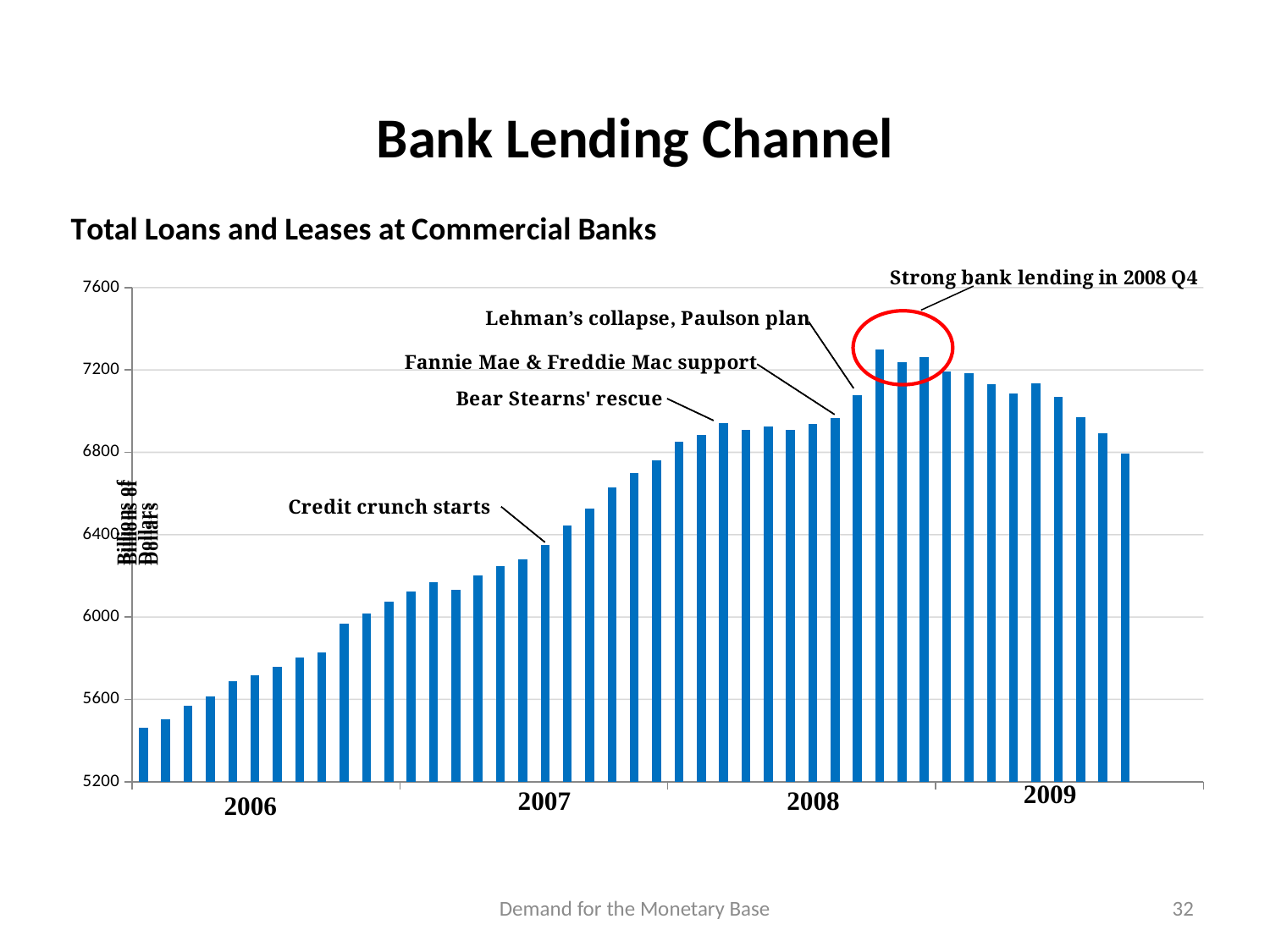
Is the value of the bar marked 'Lehman's collapse, Paulson plan' greater or less than 7200? less In which year does the highest bar of the chart occur? 2008 Is the value of the bar marked 'Bear Stearns' rescue' greater or less than 6800? greater Do the values rise or fall across the bars in 2009? fall What is the title of the chart? Total Loans and Leases at Commercial Banks Is the value of the bar marked 'Credit crunch starts' greater or less than 6400? less What kind of chart is shown on the slide? bar chart Which is larger: the bar marked 'Bear Stearns' rescue' or the bar marked 'Lehman's collapse, Paulson plan'? Lehman's collapse, Paulson plan What is the label on the vertical axis of the chart? Billions of Dollars Do the values rise or fall from the start of 2006 to the end of 2008? rise